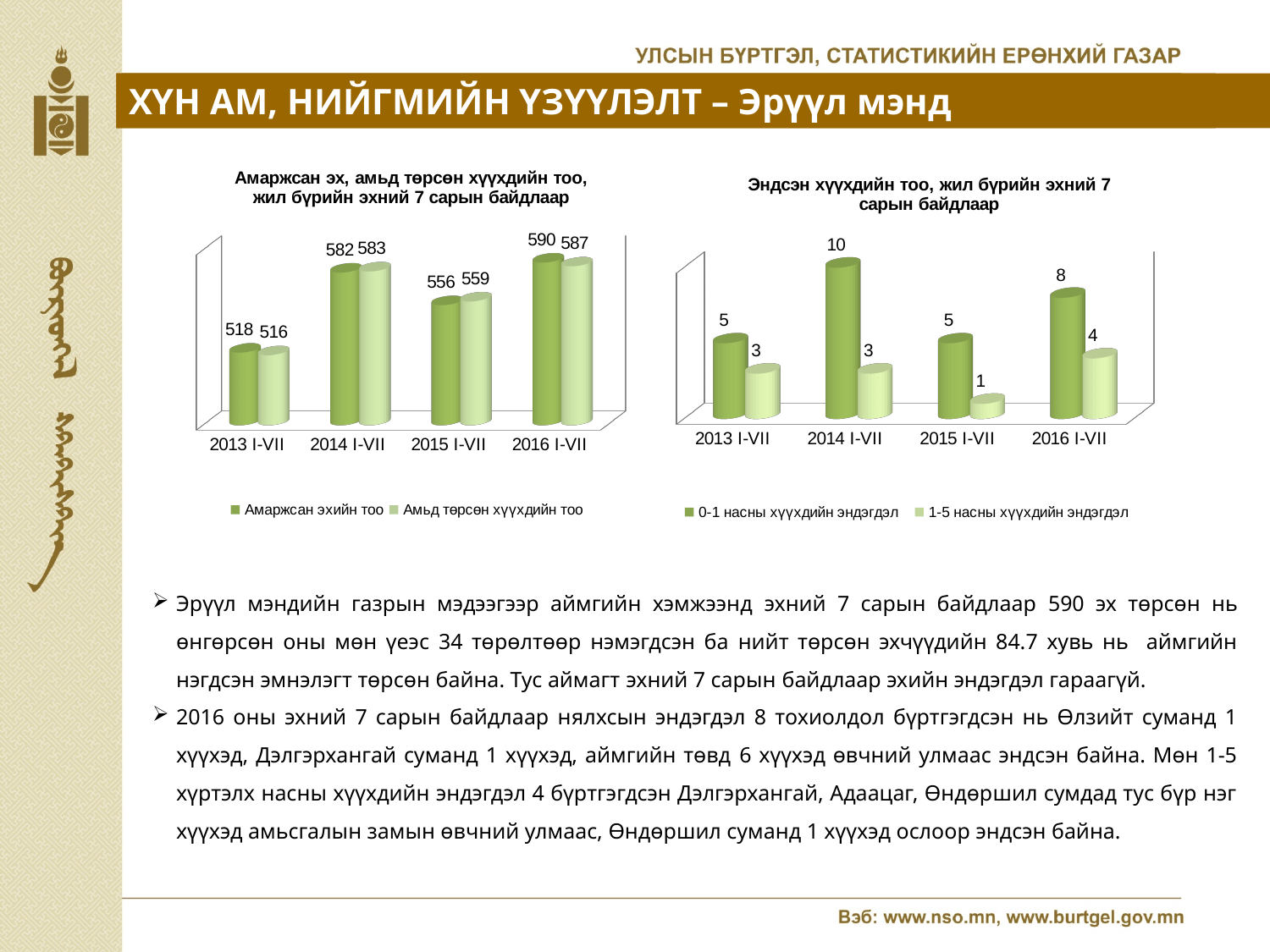
In the right chart (Эндсэн хүүхдийн тоо), what is the value of 1-5 насны хүүхдийн эндэгдэл for 2015 I-VII? 1 In the right chart (Эндсэн хүүхдийн тоо), what is the value of 0-1 насны хүүхдийн эндэгдэл for 2014 I-VII? 10 In the left chart (Амаржсан эх, амьд төрсөн хүүхдийн тоо), what is the difference between Амаржсан эхийн тоо in 2016 I-VII and 2015 I-VII? 34 In the right chart (Эндсэн хүүхдийн тоо), which year has the highest value for 0-1 насны хүүхдийн эндэгдэл? 2014 I-VII In the right chart (Эндсэн хүүхдийн тоо), what is the difference between 0-1 насны and 1-5 насны хүүхдийн эндэгдэл in 2014 I-VII? 7 In the right chart (Эндсэн хүүхдийн тоо), which is larger in 2016 I-VII: 0-1 насны хүүхдийн эндэгдэл or 1-5 насны хүүхдийн эндэгдэл? 0-1 насны хүүхдийн эндэгдэл In the left chart (Амаржсан эх, амьд төрсөн хүүхдийн тоо), how many series does the legend list? 2 In the left chart (Амаржсан эх, амьд төрсөн хүүхдийн тоо), what is the value of Амаржсан эхийн тоо for 2016 I-VII? 590 What kind of chart is the left chart (Амаржсан эх, амьд төрсөн хүүхдийн тоо)? Bar chart How many year categories are shown on the x axis of the right chart (Эндсэн хүүхдийн тоо)? 4 In the left chart (Амаржсан эх, амьд төрсөн хүүхдийн тоо), what is the value of Амьд төрсөн хүүхдийн тоо for 2013 I-VII? 516 In the left chart (Амаржсан эх, амьд төрсөн хүүхдийн тоо), which year has the lowest value for Амаржсан эхийн тоо? 2013 I-VII